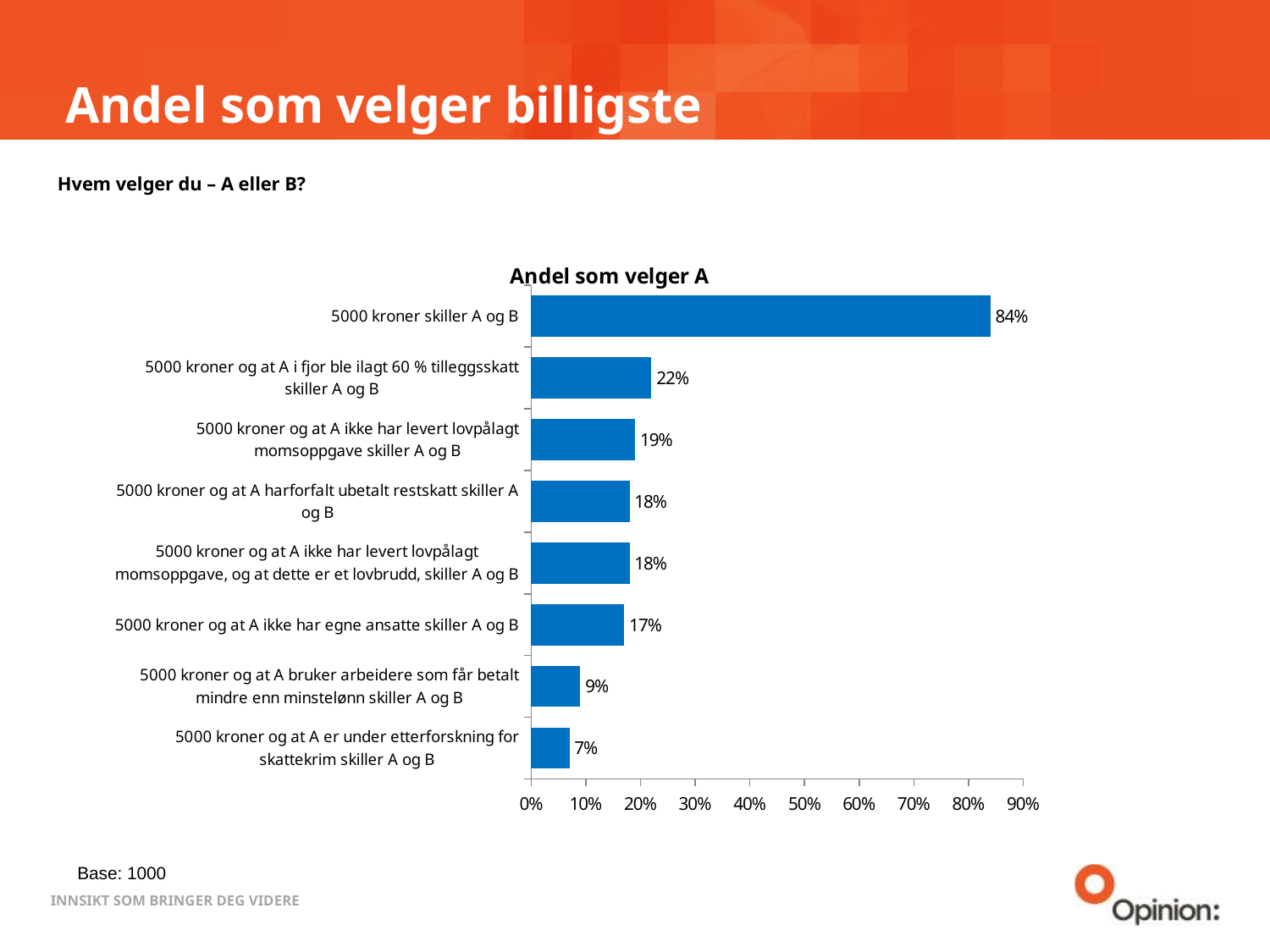
Is the value for "5000 kroner og at A ikke har levert lovpålagt momsoppgave skiller A og B" greater or less than 30%? less How many categories are shown in the chart? 8 Which category has the highest value? 5000 kroner skiller A og B Which category has the lowest value? 5000 kroner og at A er under etterforskning for skattekrim skiller A og B Which is larger: the value for "5000 kroner og at A bruker arbeidere som får betalt mindre enn minstelønn skiller A og B" or the value for "5000 kroner og at A ikke har egne ansatte skiller A og B"? 5000 kroner og at A ikke har egne ansatte skiller A og B What is the value for "5000 kroner og at A er under etterforskning for skattekrim skiller A og B"? 7% What kind of chart is shown on the slide? bar chart What is the value for "5000 kroner og at A i fjor ble ilagt 60 % tilleggsskatt skiller A og B"? 22% What is the value for "5000 kroner og at A ikke har egne ansatte skiller A og B"? 17% What is the difference between the value for "5000 kroner skiller A og B" and the value for "5000 kroner og at A i fjor ble ilagt 60 % tilleggsskatt skiller A og B"? 62% What is the value for "5000 kroner skiller A og B"? 84% What is the title of the chart? Andel som velger A